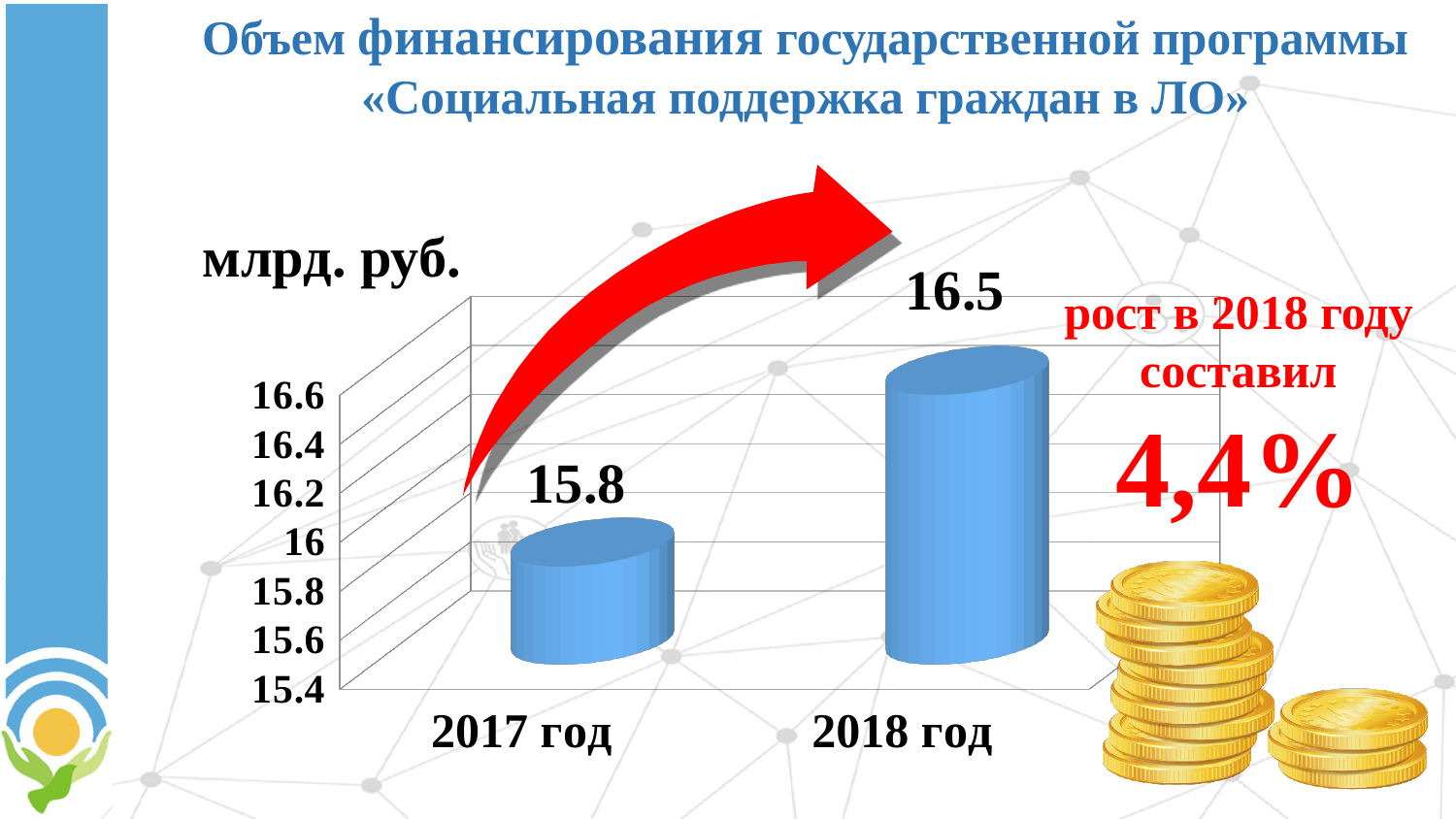
What is the funding value for 2017 год? 15.8 Which year has the higher funding value? 2018 год Do the values rise or fall from 2017 год to 2018 год? rise What is the difference between the 2018 год and 2017 год values? 0.7 What is the funding value for 2018 год? 16.5 Is the value for 2017 год larger or smaller than the value for 2018 год? smaller How many years are shown on the chart? 2 What kind of chart is shown on the slide? bar chart What unit is indicated for the values on the chart? млрд. руб. Is the value for 2018 год greater or less than 16? greater Which year has the lower funding value? 2017 год What growth percentage for 2018 is stated on the slide? 4,4%